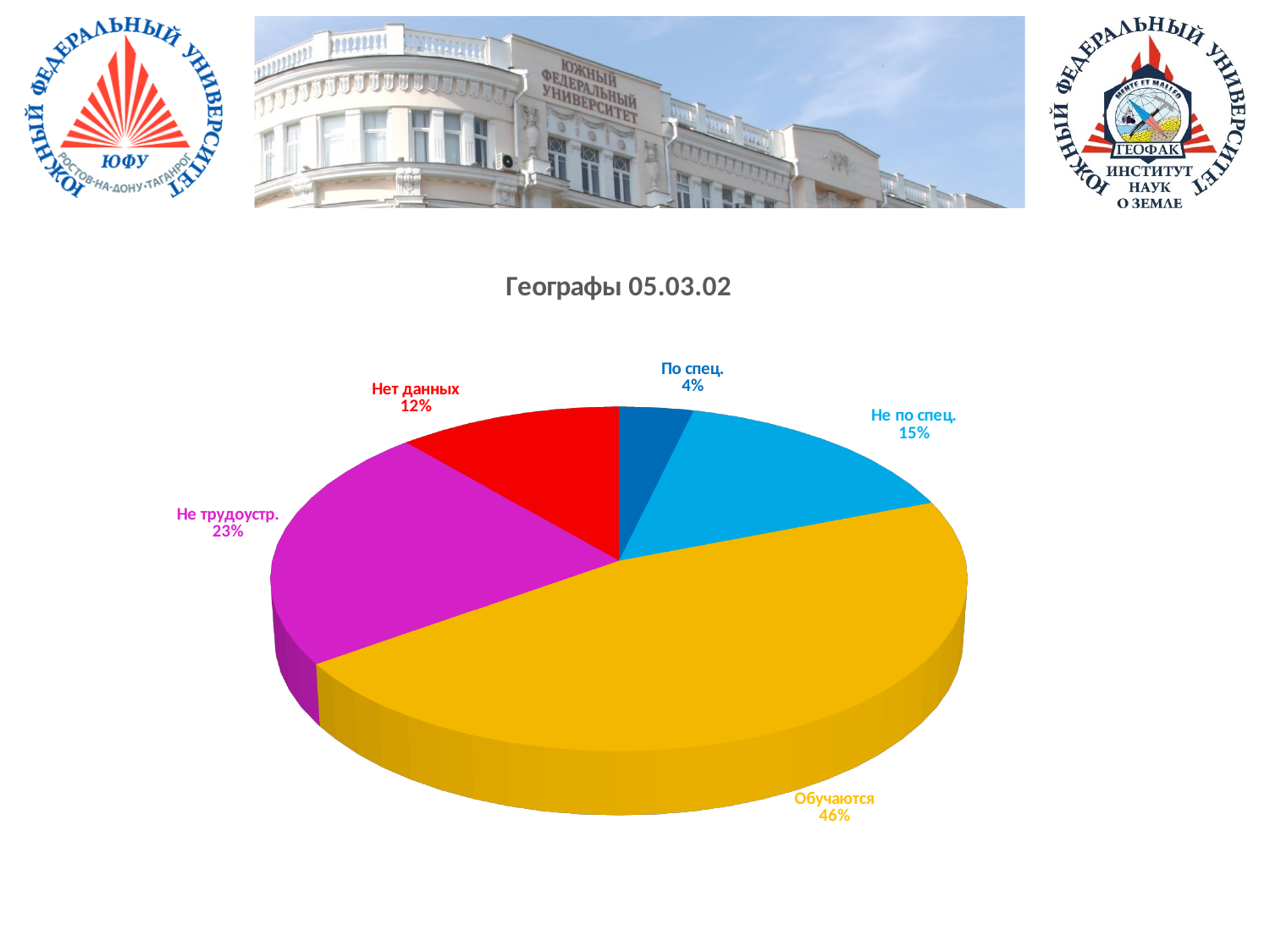
What is the value for "По спец."? 4% What is the value for "Нет данных"? 12% What is the title of the chart? Географы 05.03.02 What share of the pie is labelled "Обучаются"? 46% Which is larger, "Не по спец." or "Нет данных"? Не по спец. What is the value for "Не трудоустр."? 23% How many slices does the pie chart have? 5 What is the difference between "Не трудоустр." and "Нет данных"? 11% Which category has the largest slice? Обучаются What is the value for "Не по спец."? 15% Which category has the smallest slice? По спец. What kind of chart is shown on the slide? pie chart